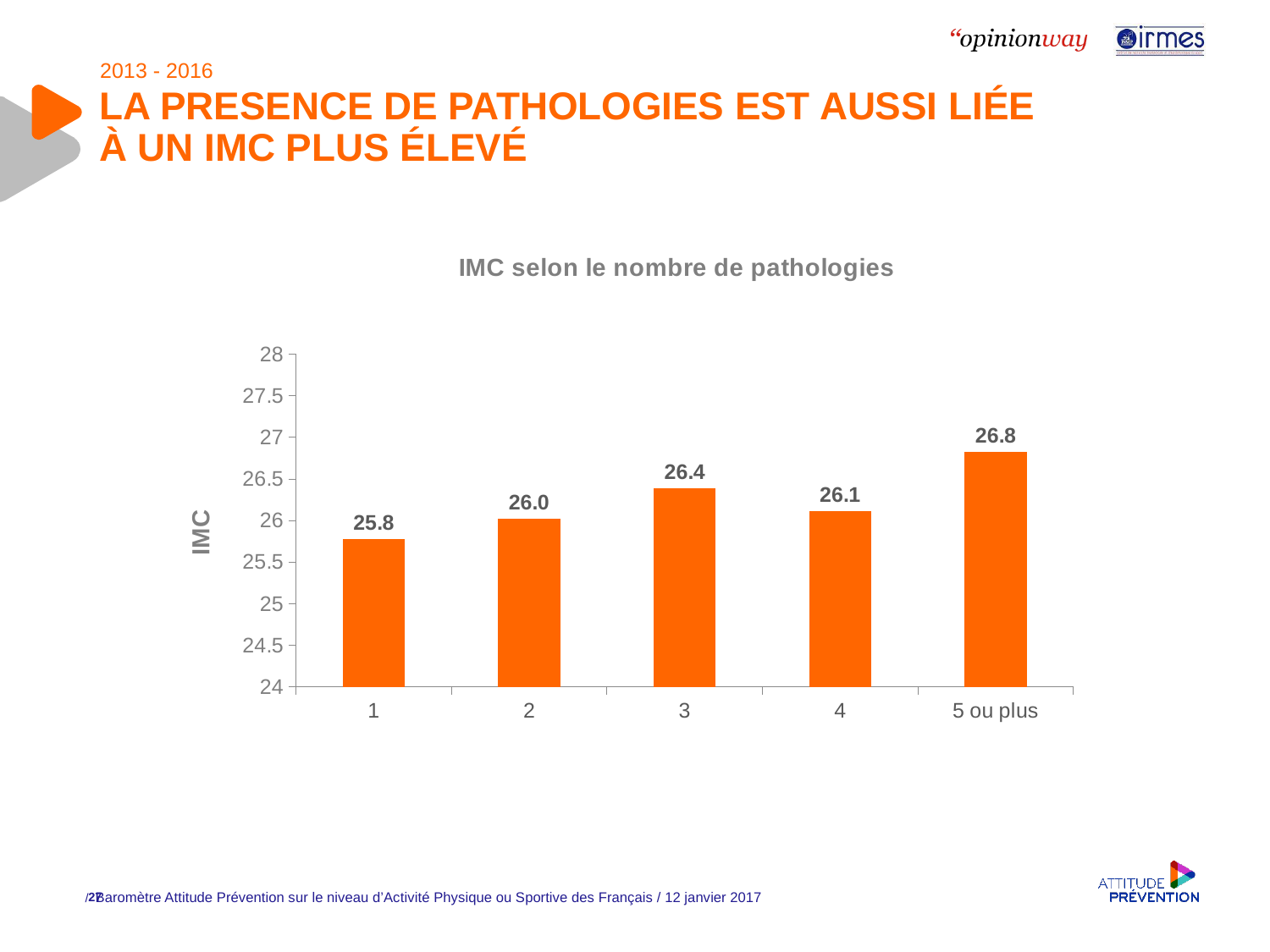
What kind of chart is shown on the slide? bar chart What is the IMC value for 3 pathologies? 26.4 What is the title of the chart? IMC selon le nombre de pathologies Which category has the lowest IMC? 1 Which category has the highest IMC? 5 ou plus What is the IMC value for the '5 ou plus' category? 26.8 What is the difference in IMC between the '5 ou plus' category and the '1' category? 1.0 What is the IMC value for 1 pathology? 25.8 How many categories are shown on the x axis? 5 Which has a higher IMC: 3 pathologies or 4 pathologies? 3 Is the IMC value for 2 pathologies greater or less than 26.5? less What is the label of the y axis? IMC